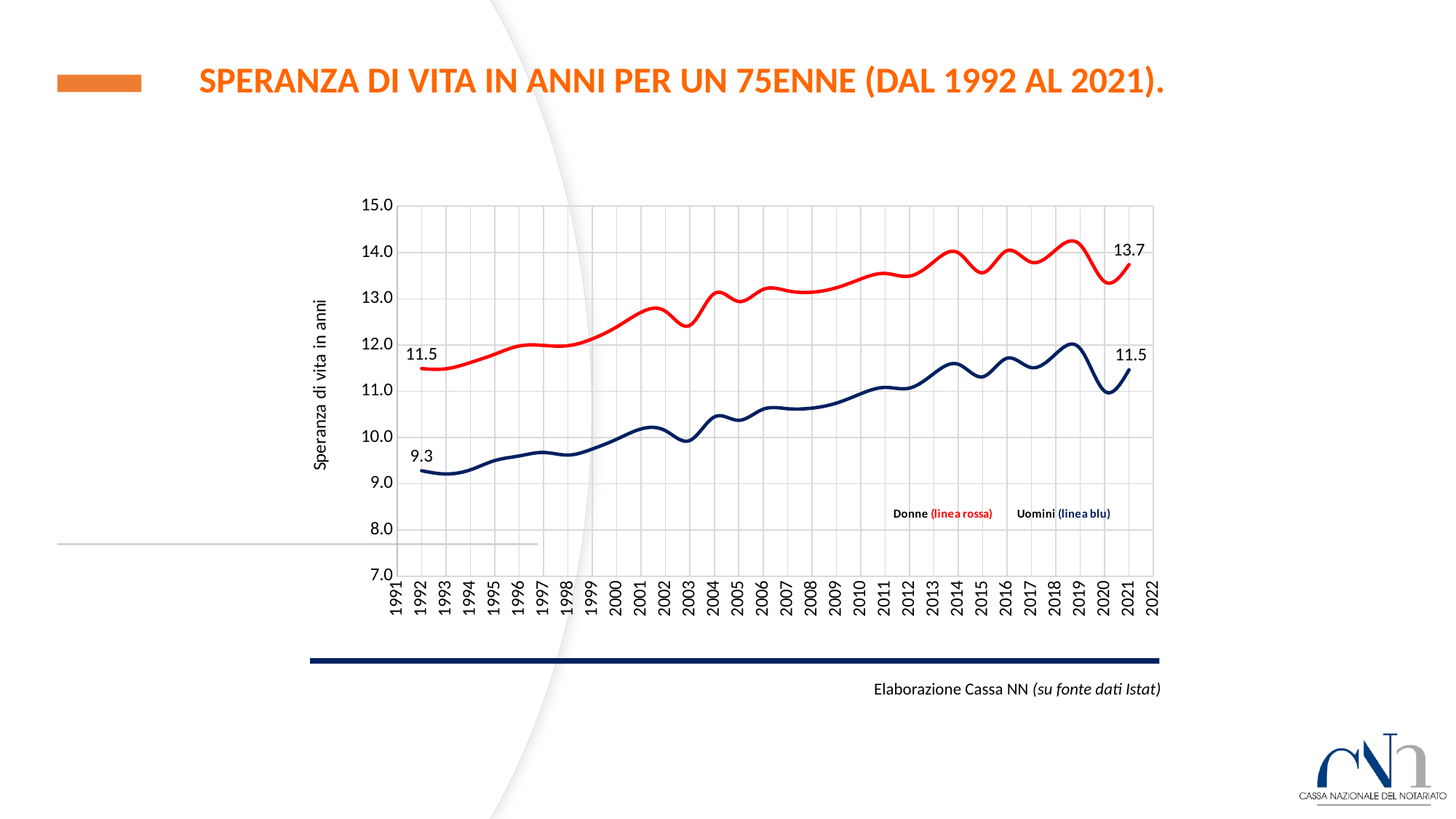
Do the values for Uomini generally rise or fall from 1992 to 2021? rise What is the life expectancy value shown for Donne (red line) in 2021? 13.7 What is the life expectancy value shown for Donne (red line) in 1992? 11.5 By how much did the Donne value increase from 1992 to 2021? 2.2 What is the life expectancy value shown for Uomini (blue line) in 1992? 9.3 What is the difference between the Donne and Uomini values in 2021? 2.2 Which series has the higher value in 2021, Donne or Uomini? Donne What kind of chart is shown on the slide? line chart Is the value for Uomini in 2019 greater or less than 11.0? greater How many series are plotted on the chart? 2 Is the value for Donne in 2003 greater or less than 13.0? less What is the life expectancy value shown for Uomini (blue line) in 2021? 11.5